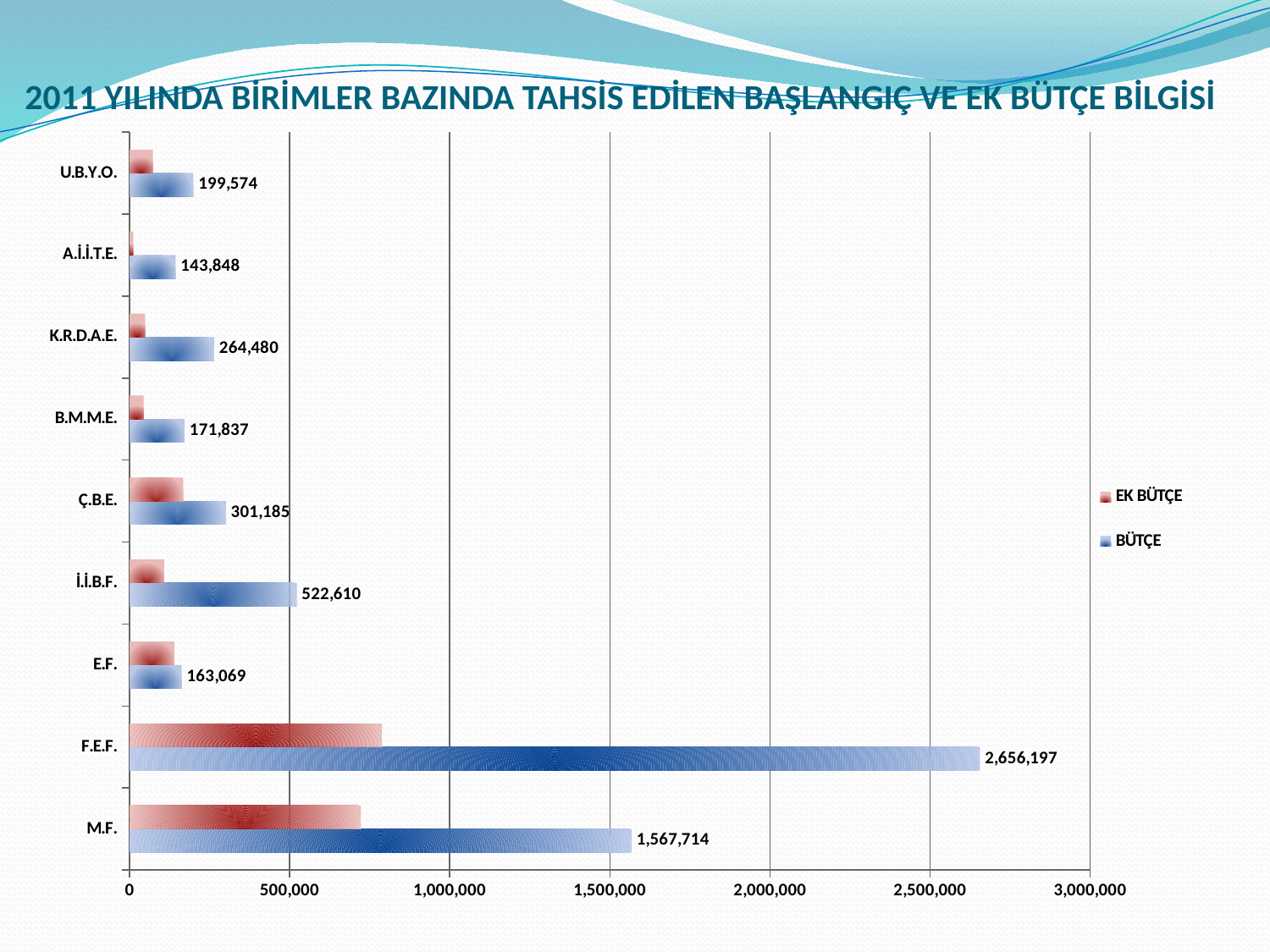
What is the BÜTÇE value for İ.İ.B.F.? 522,610 What is the difference between the BÜTÇE values of F.E.F. and M.F.? 1,088,483 Is the EK BÜTÇE value for F.E.F. greater or less than 500,000? greater How many units are shown on the chart? 9 Which has a larger BÜTÇE value, K.R.D.A.E. or Ç.B.E.? Ç.B.E. What is the BÜTÇE value for F.E.F.? 2,656,197 Which unit has the highest BÜTÇE value? F.E.F. Which series is shown in red according to the legend? EK BÜTÇE Which unit has the lowest BÜTÇE value? A.İ.İ.T.E. What kind of chart is shown on the slide? bar chart What is the BÜTÇE value for A.İ.İ.T.E.? 143,848 How many series does the legend list? 2